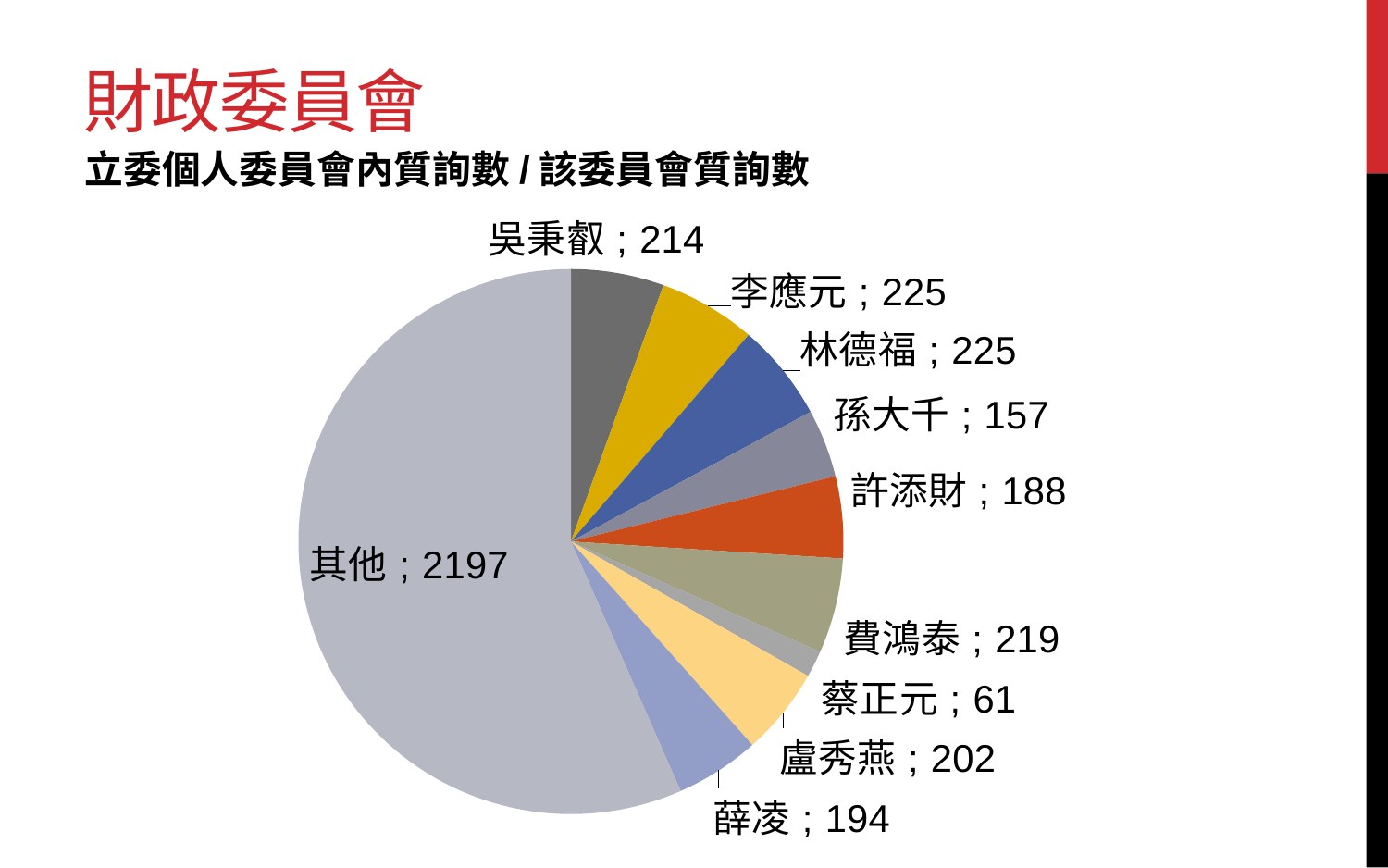
What is the value shown for 孫大千? 157 Which slice of the pie chart has the largest value? 其他 Which has a larger value, 盧秀燕 or 薛凌? 盧秀燕 How many slices does the pie chart have? 10 What is the difference between the values for 費鴻泰 and 蔡正元? 158 What is the value shown for 吳秉叡? 214 What is the difference between the values for 李應元 and 孫大千? 68 What is the title of the slide containing the pie chart? 財政委員會 What is the value shown for 蔡正元? 61 Which slice of the pie chart has the smallest value? 蔡正元 What is the value shown for 其他? 2197 What kind of chart is shown on the slide? pie chart